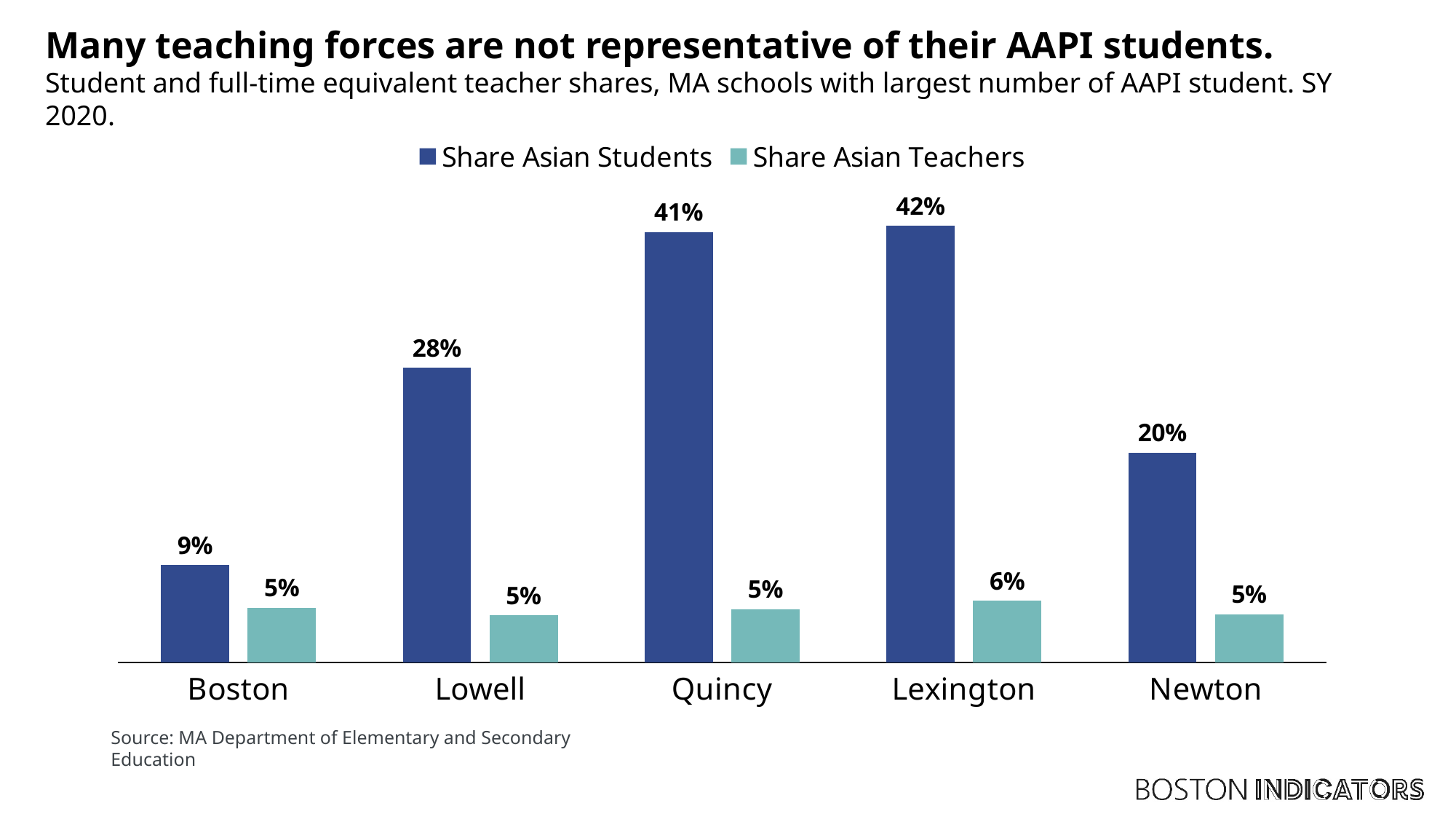
Which series is shown in dark blue? Share Asian Students What is the difference between Share Asian Students in Lexington and in Newton? 22% Which is larger: Share Asian Students in Lowell or in Newton? Lowell What is the difference between Share Asian Students and Share Asian Teachers in Lowell? 23% What is the Share Asian Students value for Newton? 20% Which district has the lowest Share Asian Students? Boston What is the Share Asian Teachers value for Lexington? 6% How many series does the legend list? 2 What kind of chart is shown on the slide? Bar chart How many districts are shown on the x axis? 5 Which district has the highest Share Asian Students? Lexington What is the Share Asian Students value for Quincy? 41%